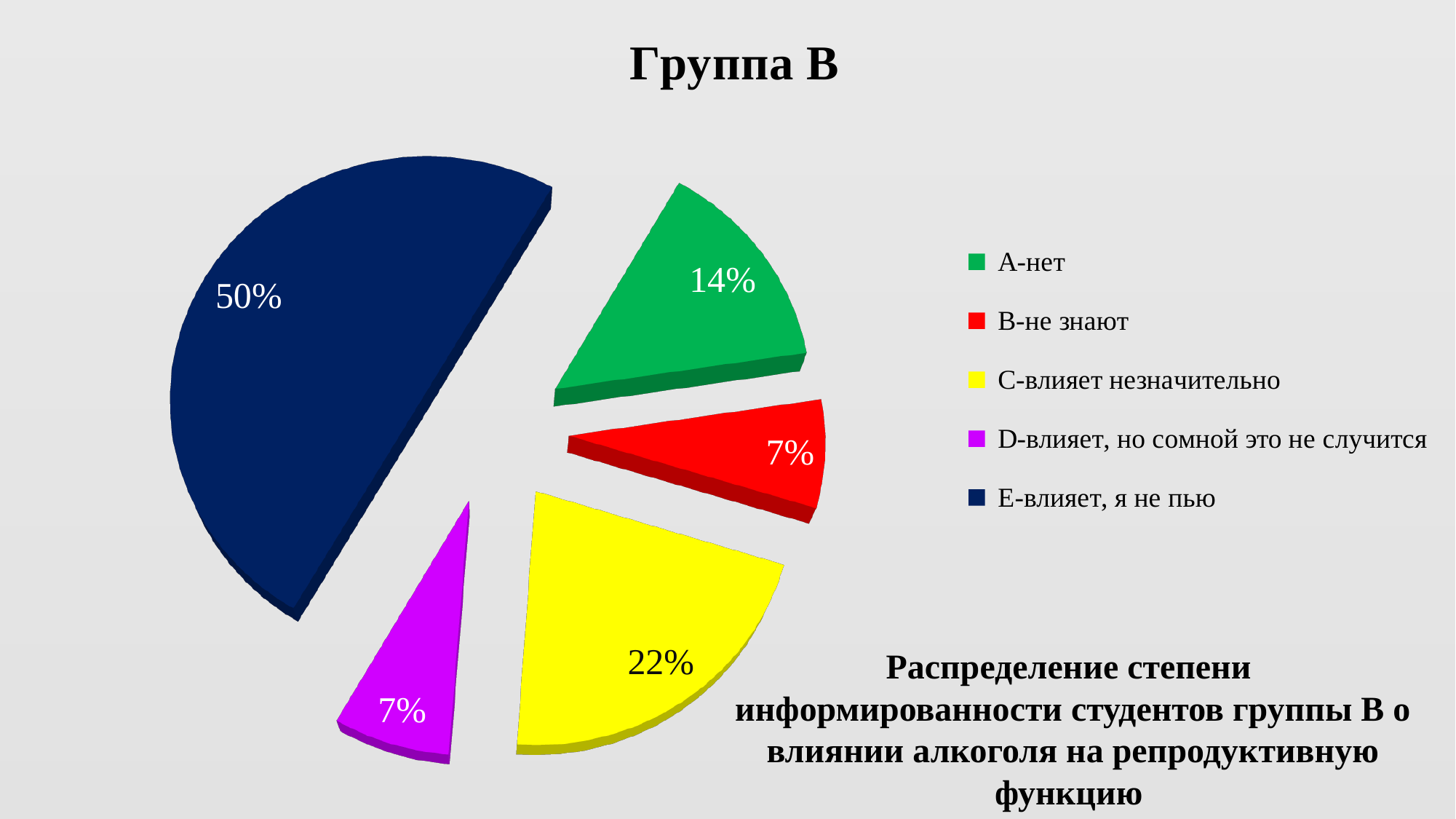
What is the title of the chart? Группа В Which category has the largest share of the pie? E-влияет, я не пью Which is larger, the share for "A-нет" or the share for "B-не знают"? A-нет How many entries does the legend list? 5 What percentage of the pie is labelled for the category "E-влияет, я не пью"? 50% What percentage is shown for the category "B-не знают"? 7% How many slices does the pie chart have? 5 What percentage is shown for the category "A-нет"? 14% What is the difference in percentage points between "E-влияет, я не пью" and "C-влияет незначительно"? 28 What colour is the slice for "C-влияет незначительно"? yellow What type of chart is shown on the slide? pie chart What percentage is shown for the category "C-влияет незначительно"? 22%